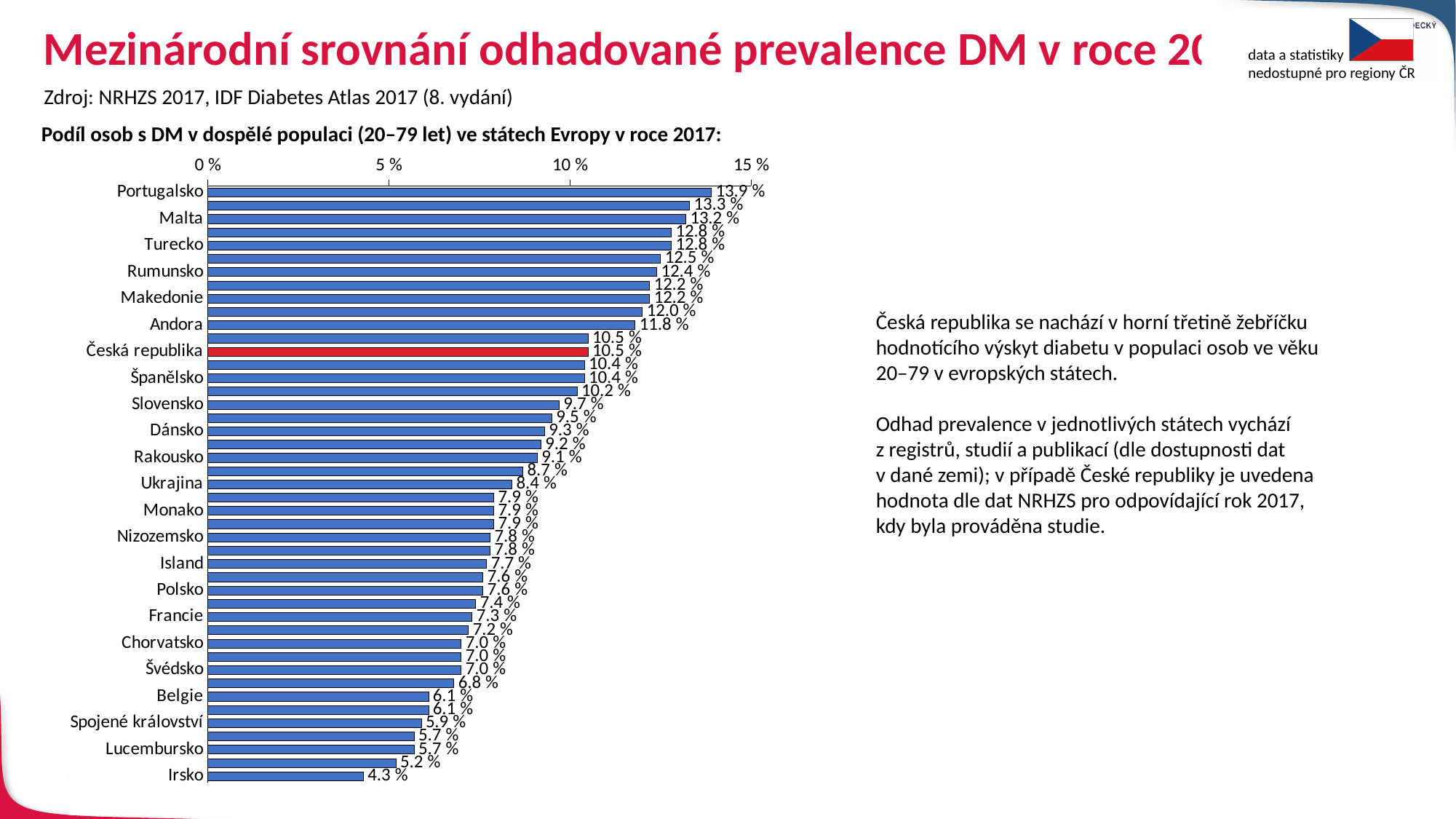
What is the value shown for Irsko? 4.3 % Do the values rise or fall going from the top bar to the bottom bar? Fall Which country's bar is highlighted in red? Česká republika What is the value shown for Česká republika? 10.5 % What kind of chart is shown on the slide? Bar chart Which has a larger value, Dánsko or Rakousko? Dánsko What is the difference between the values for Portugalsko and Irsko? 9.6 percentage points Is the value for Andora greater or less than 10 %? greater What is the value shown for Portugalsko? 13.9 % Which country has the lowest value in the chart? Irsko What is the value shown for Španělsko? 10.4 % Which country has the highest value in the chart? Portugalsko